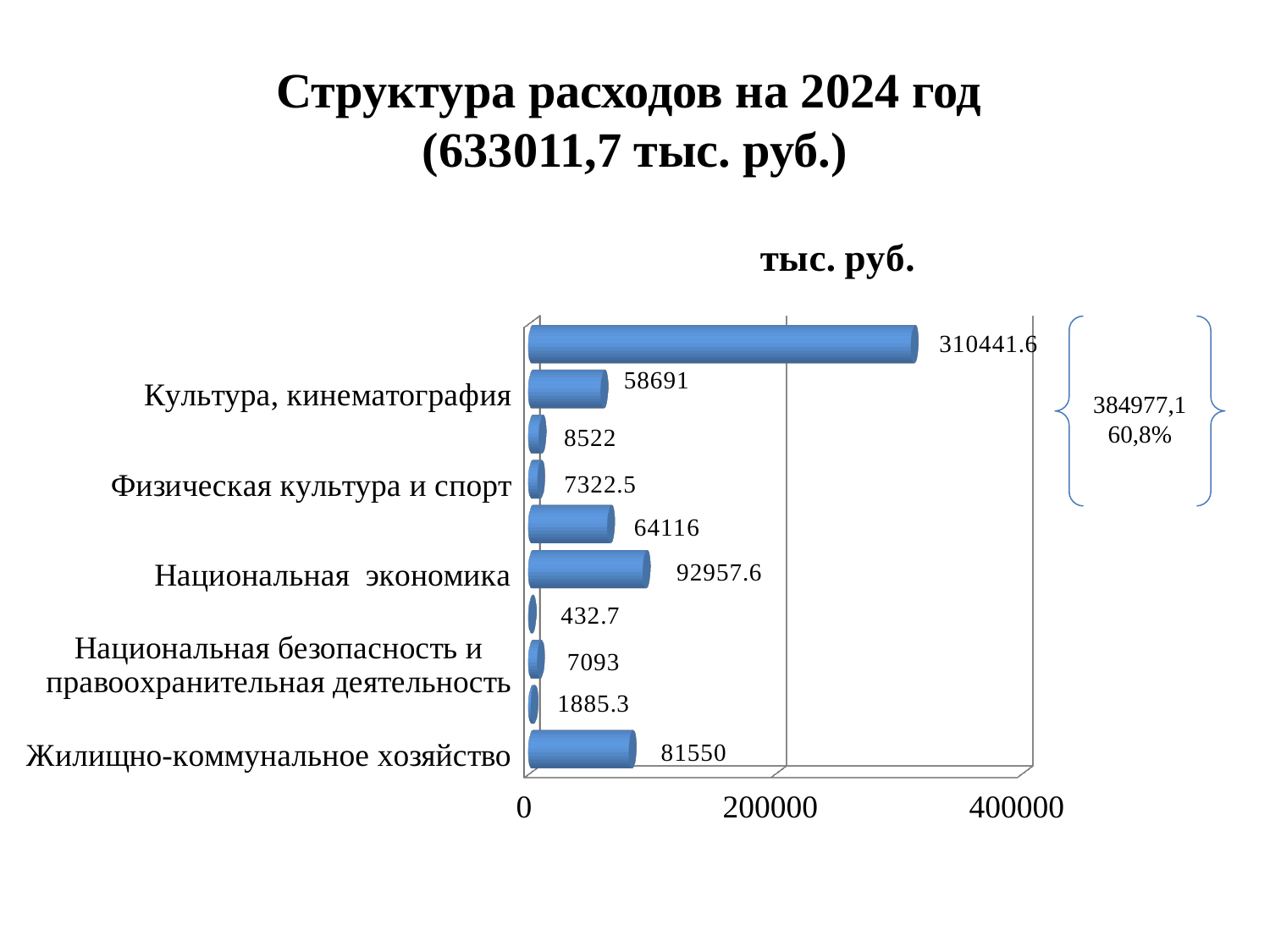
What is the value for Национальная экономика? 92957.6 How many bars are plotted in the chart? 10 What is the largest value shown by any bar in the chart? 310441.6 What is the difference between the values for Национальная экономика and Жилищно-коммунальное хозяйство? 11407.6 What type of chart is shown on the slide? bar chart What is the value for Культура, кинематография? 58691 What is the smallest value shown by any bar in the chart? 432.7 What is the value for Жилищно-коммунальное хозяйство? 81550 What unit is shown above the chart? тыс. руб. Which is larger, the value for Национальная экономика or the value for Жилищно-коммунальное хозяйство? Национальная экономика What is the value for Национальная безопасность и правоохранительная деятельность? 7093 What is the value for Физическая культура и спорт? 7322.5